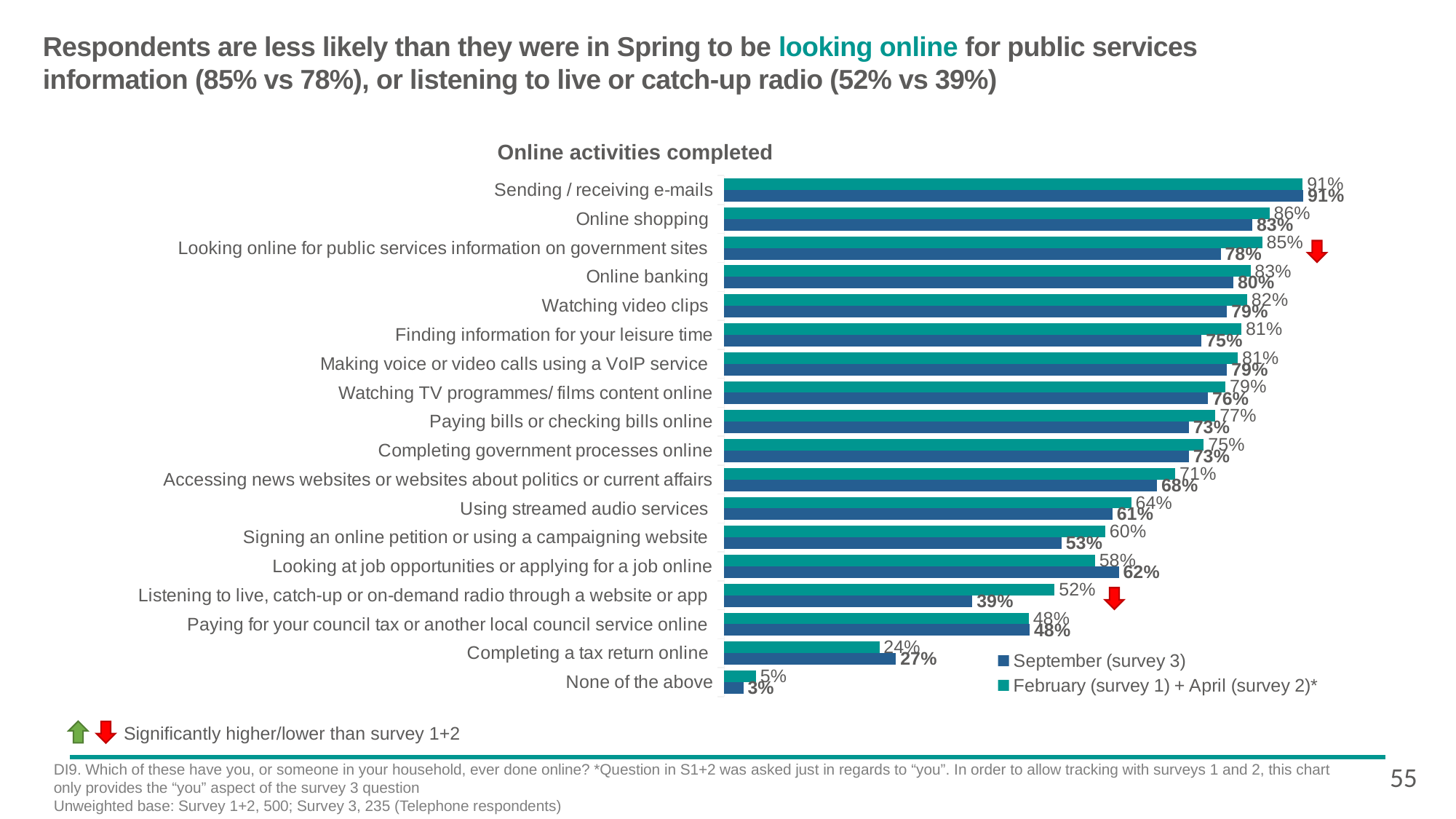
For Looking at job opportunities or applying for a job online, which is larger: the September (survey 3) value or the February + April value? September (survey 3) What is the difference between the February + April value and the September value for Looking online for public services information on government sites? 7 percentage points What is the September (survey 3) value for Paying for your council tax or another local council service online? 48% What is the September (survey 3) value for Completing a tax return online? 27% Which activity has the highest September (survey 3) value? Sending / receiving e-mails What is the February (survey 1) + April (survey 2) value for Listening to live, catch-up or on-demand radio through a website or app? 52% What is the September (survey 3) value for Online shopping? 83% How many series does the legend list? 2 What is the title of the chart? Online activities completed What kind of chart is shown on the slide? Bar chart Which category has the lowest February (survey 1) + April (survey 2) value? None of the above How many activity categories are shown in the chart? 18